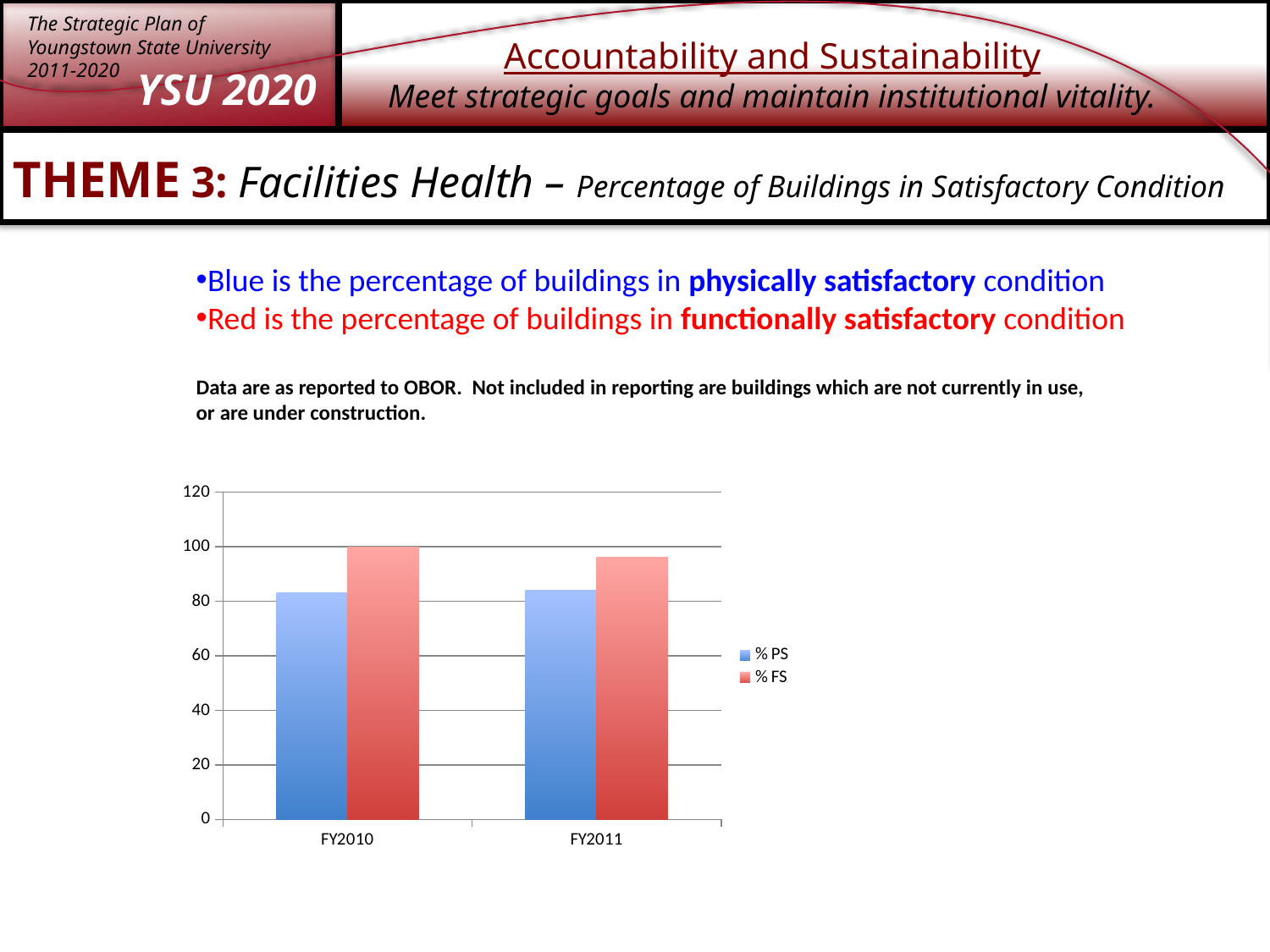
How many series does the chart's legend list? 2 Is the value for % PS in FY2011 greater or less than 100? less What kind of chart is shown on the slide? bar chart Which colour represents the % FS series in the chart? red What are the two series names listed in the chart's legend? % PS and % FS Is the value for % FS in FY2011 greater or less than 80? greater In FY2010, which series has the larger value, % PS or % FS? % FS How many categories are shown on the x axis of the chart? 2 Is the value for % PS in FY2010 greater or less than 80? greater In FY2011, which series has the larger value, % PS or % FS? % FS For the % FS series, which year has the higher value, FY2010 or FY2011? FY2010